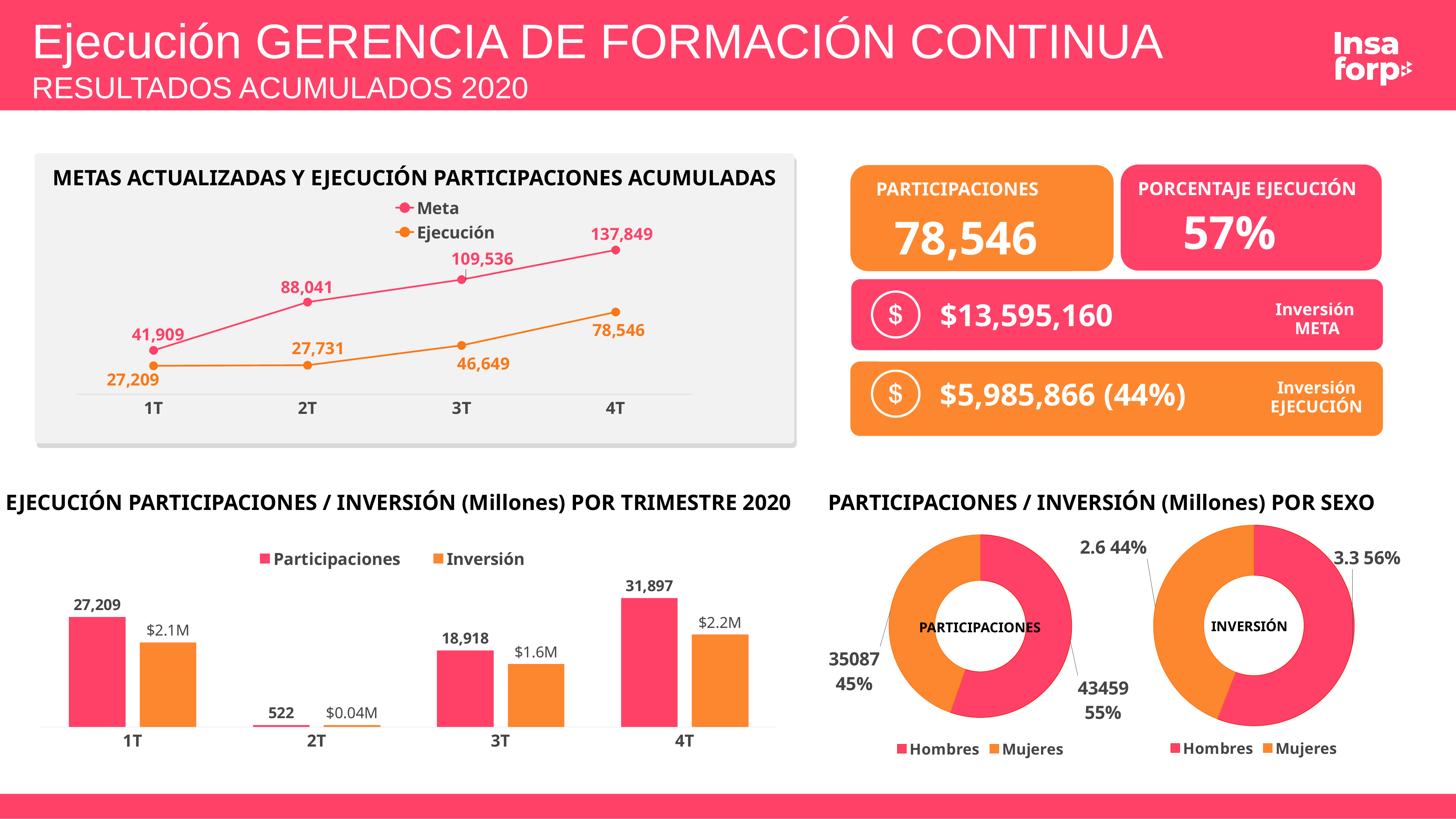
In the line chart 'METAS ACTUALIZADAS Y EJECUCIÓN PARTICIPACIONES ACUMULADAS', what is the Ejecución value for 3T? 46,649 In the PARTICIPACIONES donut chart on the bottom right, what share of participations corresponds to Hombres? 55% In the line chart 'METAS ACTUALIZADAS Y EJECUCIÓN PARTICIPACIONES ACUMULADAS', does the Meta series rise or fall from 1T to 4T? rise In the line chart 'METAS ACTUALIZADAS Y EJECUCIÓN PARTICIPACIONES ACUMULADAS', how many series does the legend list? 2 In the bar chart 'EJECUCIÓN PARTICIPACIONES / INVERSIÓN (Millones) POR TRIMESTRE 2020', what is the Participaciones value for 3T? 18,918 What kind of chart is 'EJECUCIÓN PARTICIPACIONES / INVERSIÓN (Millones) POR TRIMESTRE 2020'? bar chart In the bar chart 'EJECUCIÓN PARTICIPACIONES / INVERSIÓN (Millones) POR TRIMESTRE 2020', which quarter has the lowest Participaciones value? 2T In the line chart 'METAS ACTUALIZADAS Y EJECUCIÓN PARTICIPACIONES ACUMULADAS', what is the difference between the Meta and Ejecución values at 4T? 59,303 In the INVERSIÓN donut chart on the bottom right, what is the value shown for Mujeres? 2.6 44% In the bar chart 'EJECUCIÓN PARTICIPACIONES / INVERSIÓN (Millones) POR TRIMESTRE 2020', what is the difference in Participaciones between 4T and 3T? 12,979 In the bar chart 'EJECUCIÓN PARTICIPACIONES / INVERSIÓN (Millones) POR TRIMESTRE 2020', what is the Inversión value for 4T? $2.2M In the line chart 'METAS ACTUALIZADAS Y EJECUCIÓN PARTICIPACIONES ACUMULADAS', what is the Meta value for 4T? 137,849